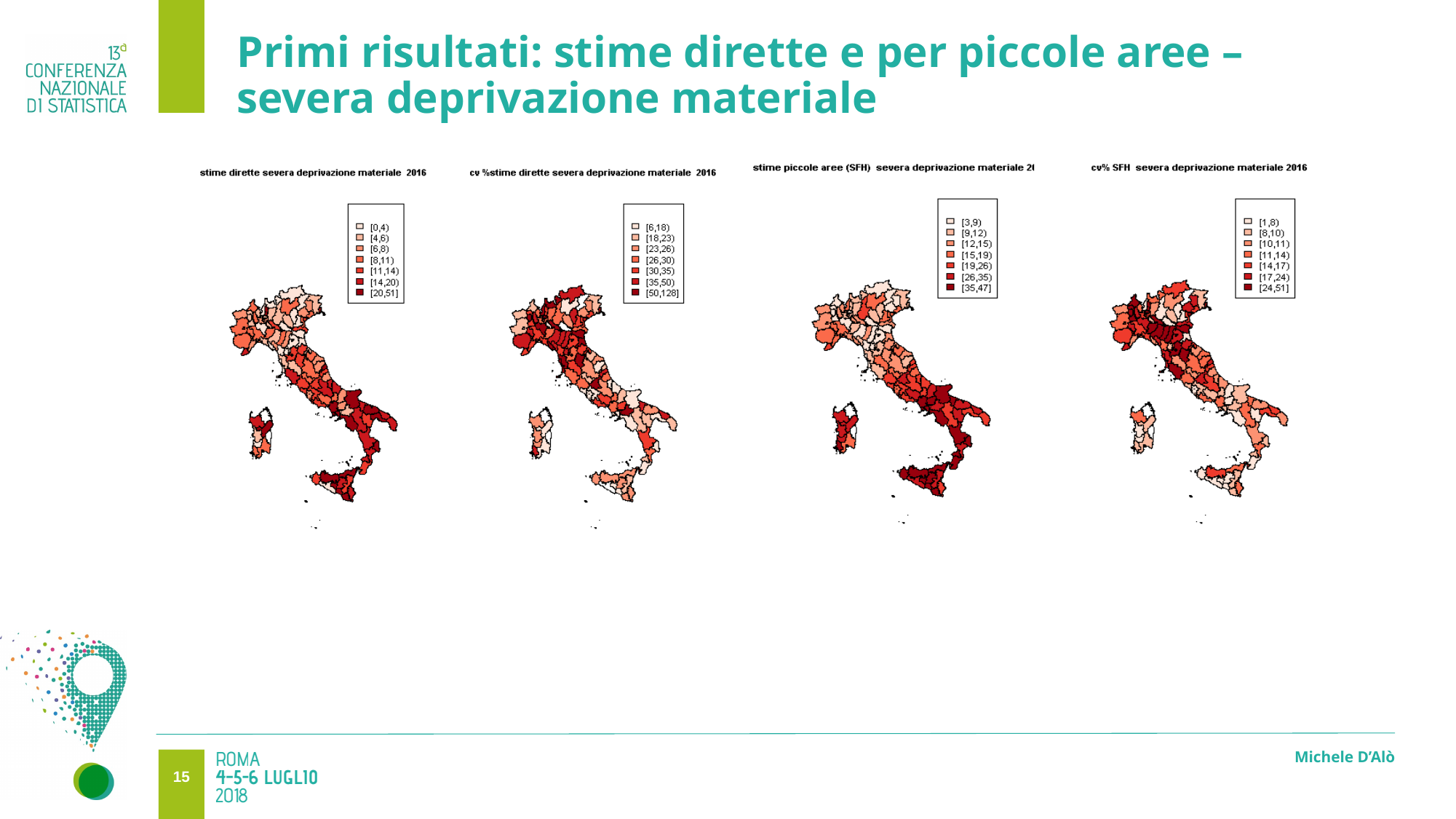
What year do the map titles refer to? 2016 Which map has the higher upper bound in its legend: the second map (cv %stime dirette) or the fourth map (cv% SFH)? The second map (cv %stime dirette), [50,128] How many maps of Italy are shown on the slide? 4 What is the title of the leftmost map? stime dirette severa deprivazione materiale 2016 What kind of chart is used on this slide to display the estimates? Choropleth map In the rightmost map (cv% SFH severa deprivazione materiale 2016), what is the lowest class interval in the legend? [1,8) How many classes does the legend of the leftmost map (stime dirette severa deprivazione materiale 2016) list? 7 How many classes does the legend of the rightmost map (cv% SFH severa deprivazione materiale 2016) list? 7 In the third map from the left (stime piccole aree (SFH) severa deprivazione materiale), what is the lowest class interval in the legend? [3,9) In the leftmost map (stime dirette severa deprivazione materiale 2016), what is the highest class interval in the legend? [20,51] In the second map from the left (cv %stime dirette severa deprivazione materiale 2016), what is the highest class interval in the legend? [50,128]